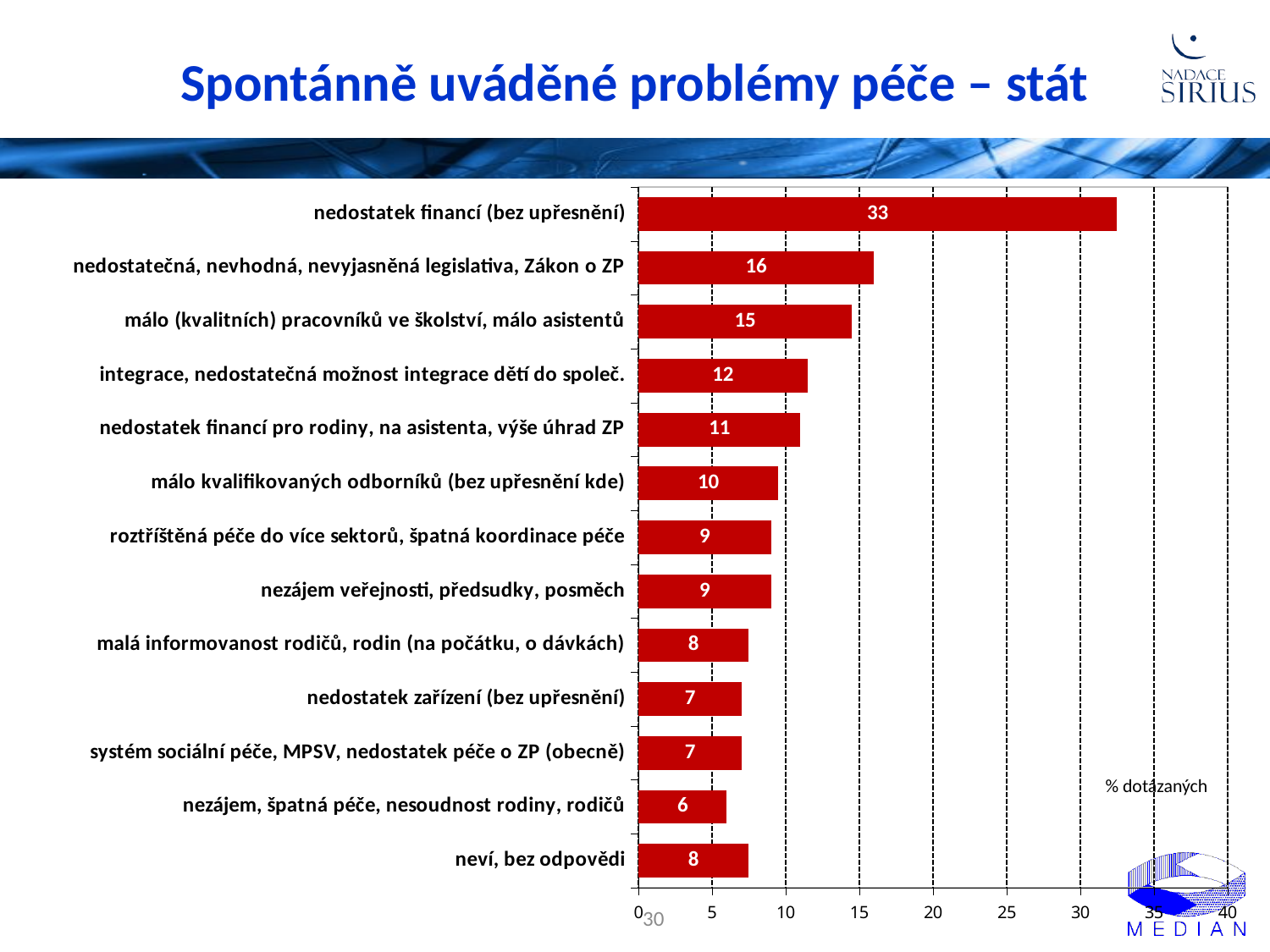
What is the difference between the values for "nedostatek financí (bez upřesnění)" and "nedostatečná, nevhodná, nevyjasněná legislativa, Zákon o ZP"? 17 How many categories are shown in the chart? 13 What value is shown for "málo (kvalitních) pracovníků ve školství, málo asistentů"? 15 Which is larger: the value for "integrace, nedostatečná možnost integrace dětí do společ." or for "nedostatek financí pro rodiny, na asistenta, výše úhrad ZP"? integrace, nedostatečná možnost integrace dětí do společ. Which category has the lowest value? nezájem, špatná péče, nesoudnost rodiny, rodičů Which category has the highest value? nedostatek financí (bez upřesnění) What value is shown for "nedostatek financí (bez upřesnění)"? 33 Is the value for "nedostatečná, nevhodná, nevyjasněná legislativa, Zákon o ZP" greater or less than 20? less What kind of chart is shown on the slide? bar chart What value is shown for "neví, bez odpovědi"? 8 What is the title of the slide? Spontánně uváděné problémy péče – stát What unit is indicated for the values in the chart? % dotázaných